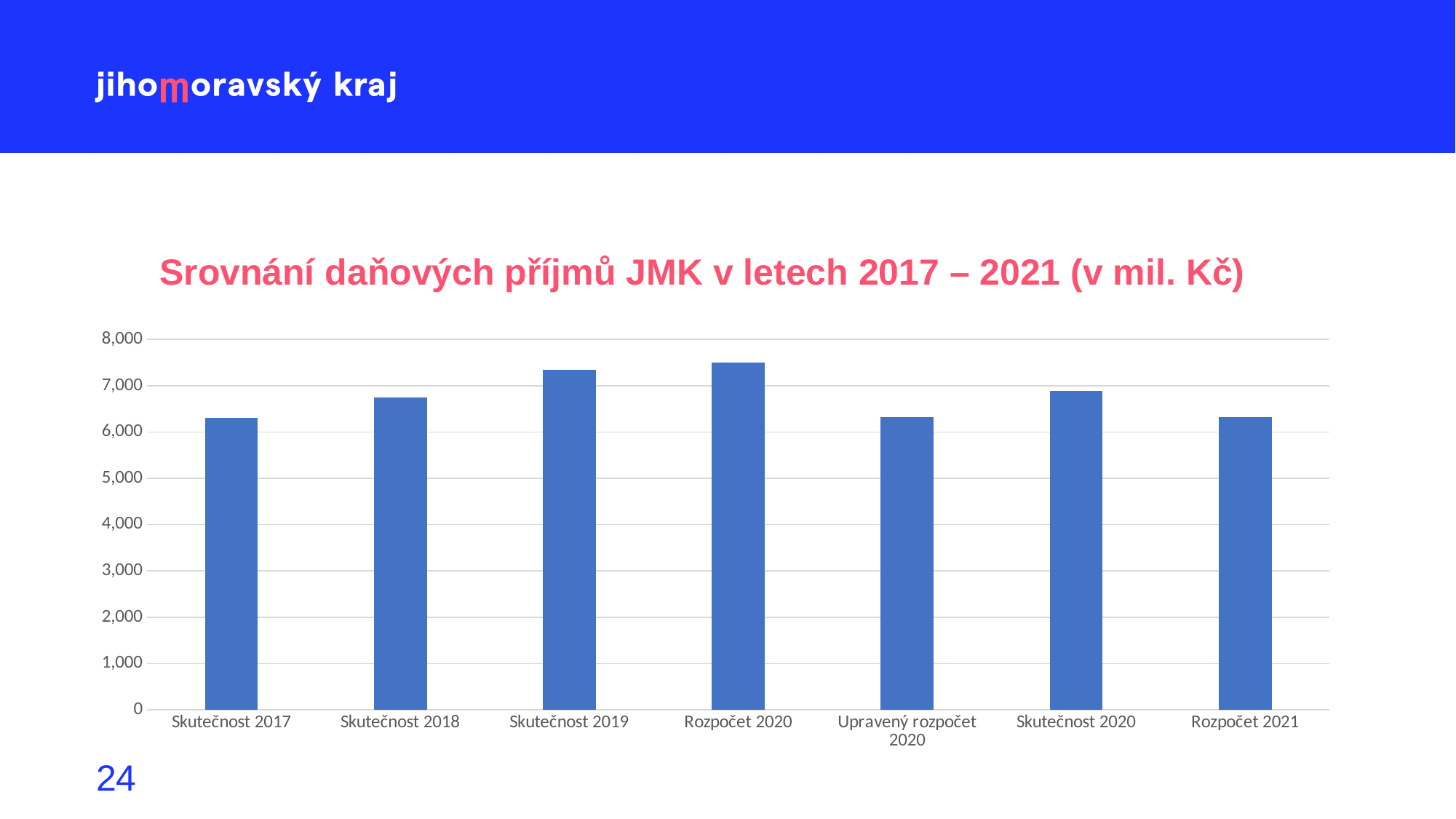
Which is larger, the value for Skutečnost 2019 or Skutečnost 2018? Skutečnost 2019 Is the value for Upravený rozpočet 2020 greater or less than 7,000? less What kind of chart is shown on the slide? bar chart How many bars (categories) are plotted in the chart? 7 Is the value for Skutečnost 2019 greater or less than 7,000? greater What is the title of the chart? Srovnání daňových příjmů JMK v letech 2017 – 2021 (v mil. Kč) Which is larger, the value for Rozpočet 2020 or Upravený rozpočet 2020? Rozpočet 2020 Do the values rise or fall from Skutečnost 2017 to Skutečnost 2019? rise Is the value for Skutečnost 2018 greater or less than 7,000? less Which category has the highest value? Rozpočet 2020